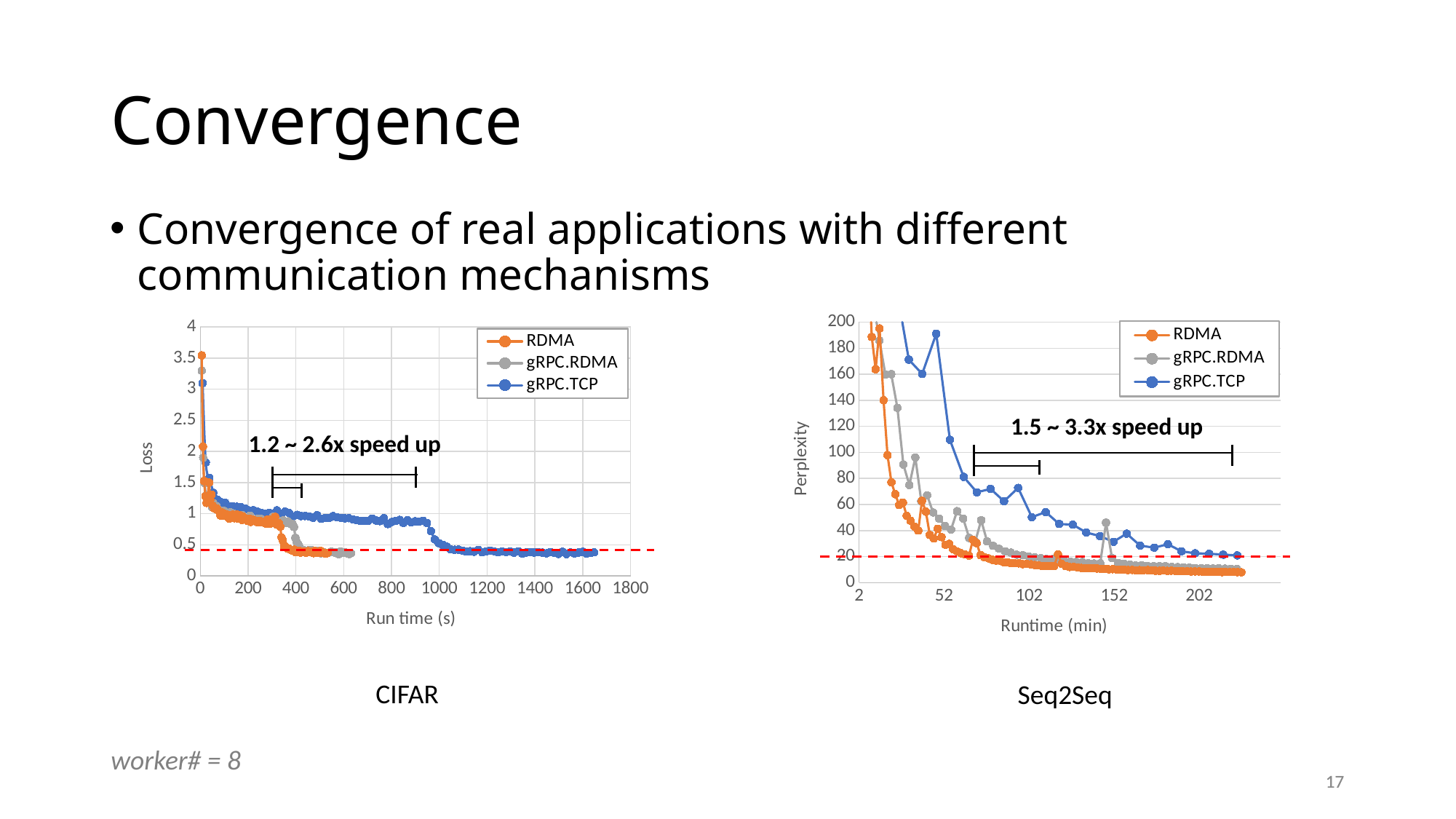
How many series does the legend of the Seq2Seq chart list? 3 How many series does the legend of the CIFAR chart list? 3 In the Seq2Seq chart, is the perplexity for gRPC.TCP at a runtime of about 52 min greater or less than 100? greater What is the x-axis label of the CIFAR chart? Run time (s) What kind of chart is the Seq2Seq chart on the right? line chart In the CIFAR chart, is the loss for gRPC.TCP at a run time of 600 s greater or less than 1.5? less What kind of chart is the CIFAR chart on the left? line chart In the Seq2Seq chart, does the perplexity for RDMA rise or fall as runtime increases? fall What speed-up range is annotated on the Seq2Seq chart? 1.5 ~ 3.3x speed up In the CIFAR chart, does the loss for gRPC.TCP rise or fall as run time increases? fall In the CIFAR chart, which series takes the longest run time to reach the dashed target loss line? gRPC.TCP